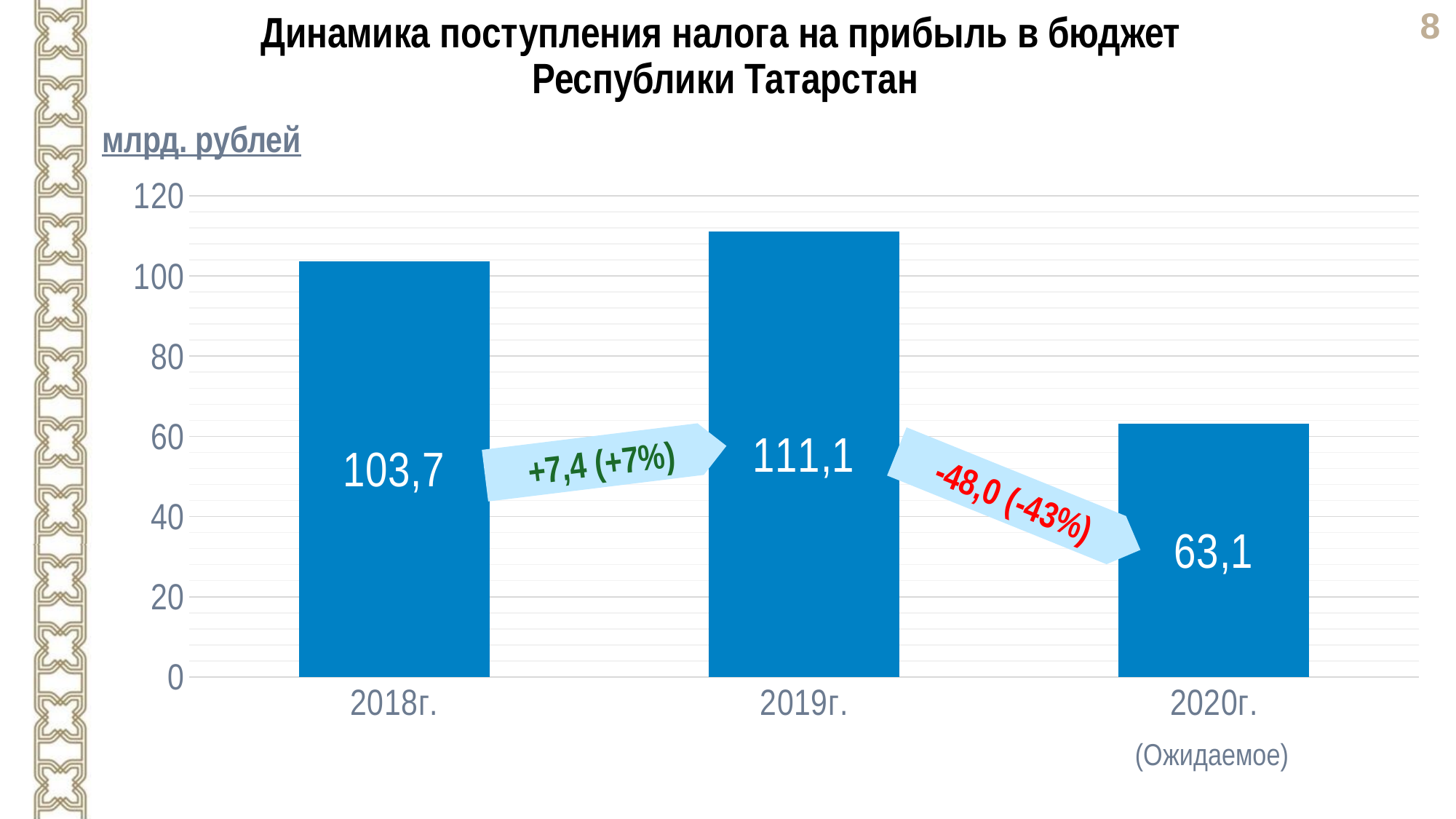
What is the value for 2018г.? 103,7 Which year has the highest value? 2019г. What is the difference between the values for 2019г. and 2018г.? 7,4 What is the expected value for 2020г.? 63,1 What is the difference between the values for 2019г. and 2020г.? 48,0 What is the value for 2019г.? 111,1 How many years are shown on the chart? 3 Which year has the lowest value? 2020г. Which is larger, the value for 2018г. or the value for 2020г.? 2018г. What unit is indicated above the chart? млрд. рублей What kind of chart is shown on the slide? bar chart Is the value for 2020г. greater or less than 80? less